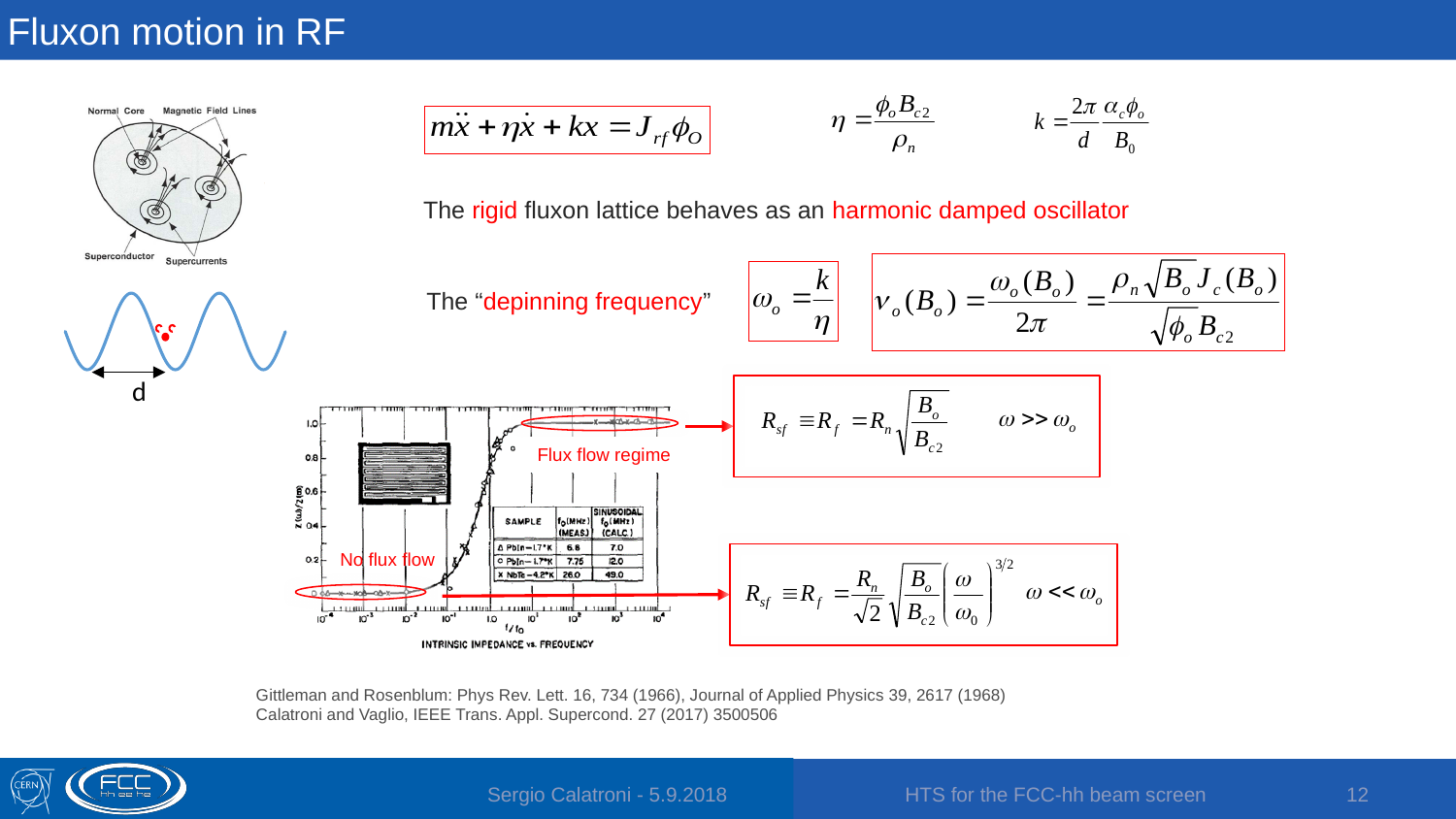
In the sample table of the 'Intrinsic impedance vs. frequency' chart, which sample has the highest measured f0 (MHz)? NbTa-4.2°K In the 'Intrinsic impedance vs. frequency' chart, which regime is labelled at the high-frequency end of the curve? Flux flow regime In the 'Intrinsic impedance vs. frequency' chart, is the plotted impedance at f/f0 = 10^2 greater or less than 0.8? greater In the sample table of the 'Intrinsic impedance vs. frequency' chart, what is the measured f0 (MHz) for the NbTa-4.2°K sample? 26.0 What kind of chart is the 'Intrinsic impedance vs. frequency' plot on the slide? scatter plot with a fitted curve In the sample table of the 'Intrinsic impedance vs. frequency' chart, what is the calculated f0 (MHz) for the PbIn-1.7°K sample marked with a circle? 12.0 In the sample table of the 'Intrinsic impedance vs. frequency' chart, what is the measured f0 (MHz) for the PbIn-1.7°K sample marked with a triangle? 6.8 What quantity is plotted on the x axis of the 'Intrinsic impedance vs. frequency' chart? f/f0 In the sample table of the 'Intrinsic impedance vs. frequency' chart, what is the calculated f0 (MHz) for the NbTa-4.2°K sample? 49.0 How many samples are listed in the sample table inside the 'Intrinsic impedance vs. frequency' chart? 3 In the 'Intrinsic impedance vs. frequency' chart, does the impedance rise or fall as the frequency ratio f/f0 increases? rise In the 'Intrinsic impedance vs. frequency' chart, is the plotted impedance at f/f0 = 10^-2 greater or less than 0.2? less